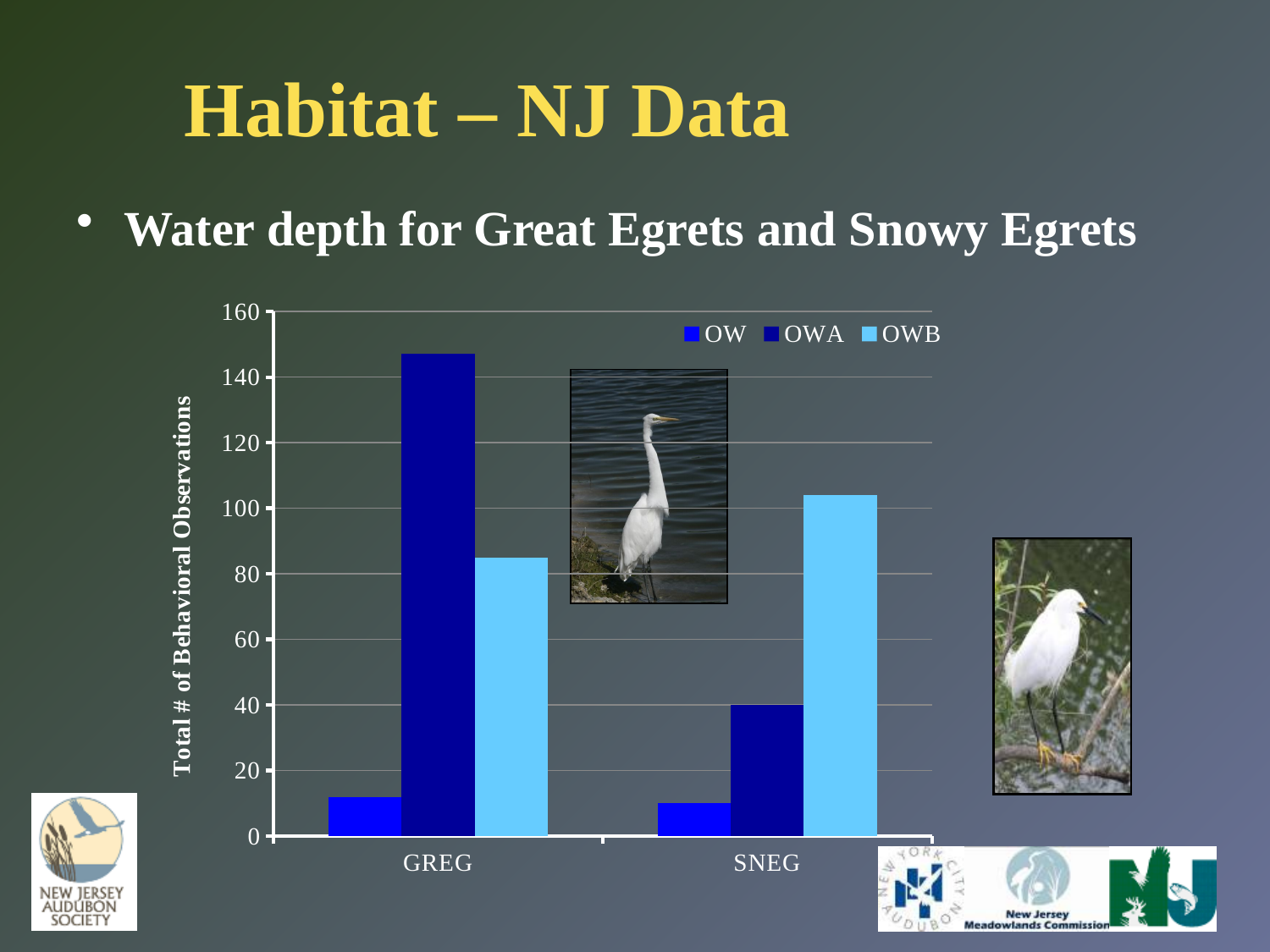
How many categories are shown on the x axis of the chart? 2 Is the OWA value for GREG greater or less than 140? greater Which category has the larger OWA value, GREG or SNEG? GREG Is the OW value for SNEG greater or less than 20? less What is the title of the y axis of the chart? Total # of Behavioral Observations Which series has the highest value for SNEG? OWB What kind of chart is shown on the slide? bar chart Which series has the lowest value for GREG? OW Which series has the highest value for GREG? OWA How many series does the chart legend list? 3 Is the OWB value for GREG greater or less than 100? less